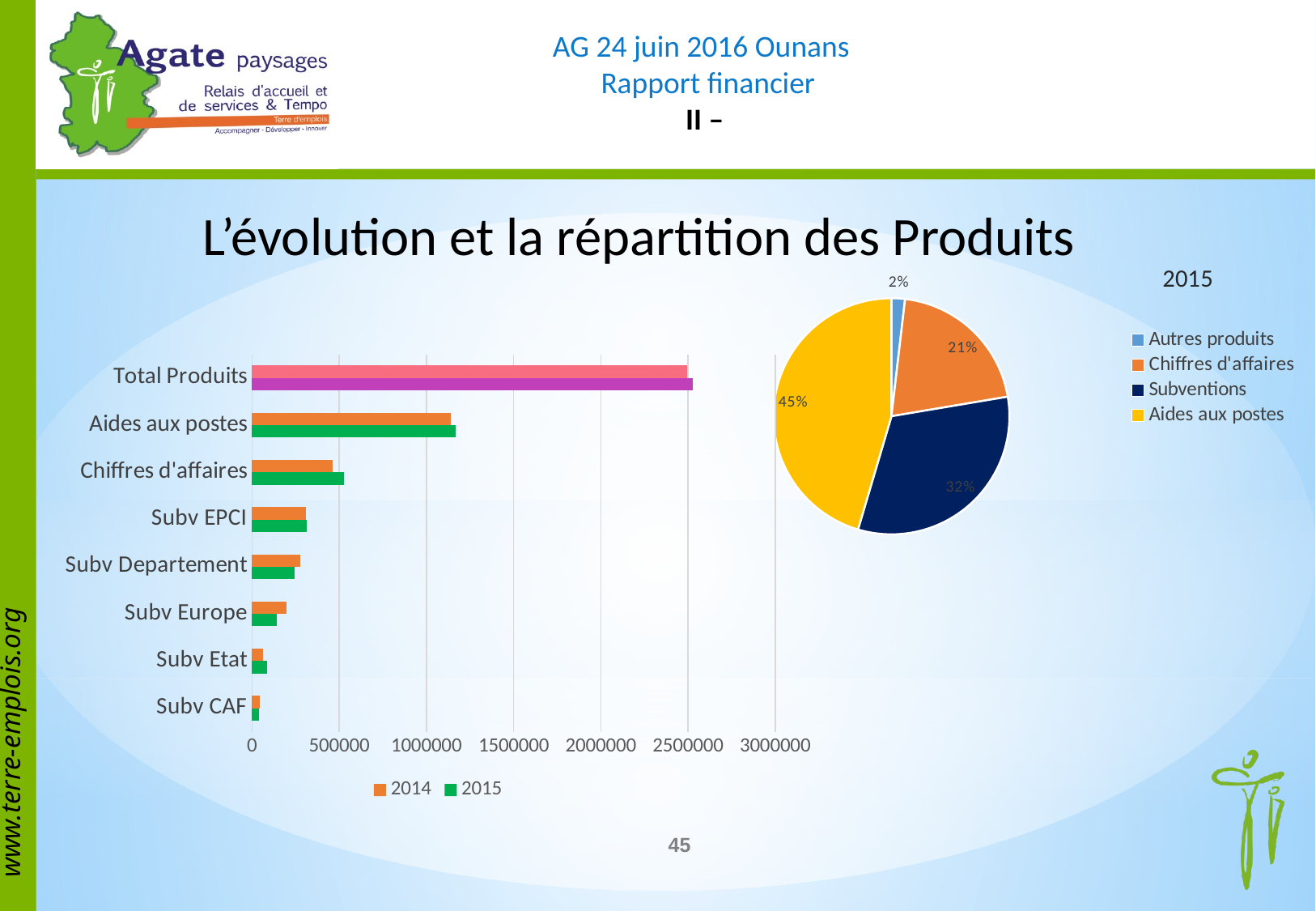
In the bar chart on the left, which is larger for Subv Europe, the 2014 value or the 2015 value? 2014 In the pie chart titled 2015, which category has the largest slice? Aides aux postes In the bar chart on the left, is the 2015 value for Aides aux postes greater or less than 1000000? greater In the pie chart titled 2015, how many percentage points larger is the Aides aux postes share than the Subventions share? 13 In the pie chart titled 2015, what share does Subventions represent? 32% In the bar chart on the left, how many categories are shown on the vertical axis? 8 In the pie chart titled 2015, which category has the smallest slice? Autres produits What kind of chart is the chart on the left of the slide? Bar chart In the bar chart on the left, how many series does the legend list? 2 In the pie chart titled 2015, how many slices are there? 4 In the pie chart titled 2015, what share does Chiffres d'affaires represent? 21% In the pie chart titled 2015, what share does Aides aux postes represent? 45%